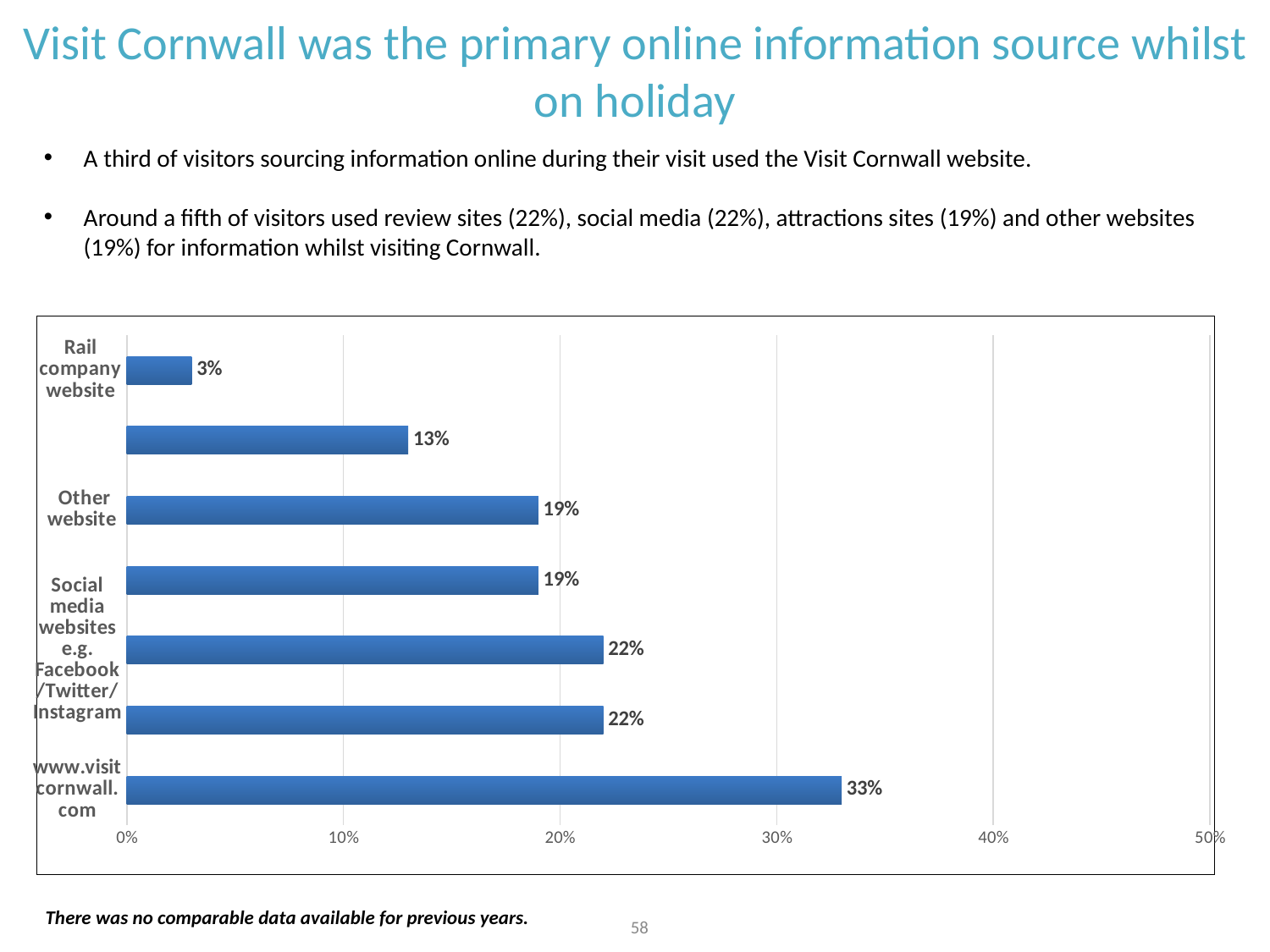
Is the value for Rail company website greater or less than 10%? less Is the value for www.visitcornwall.com greater or less than 30%? greater What is the value for Rail company website? 3% How many bars are plotted in the chart? 7 What is the value for www.visitcornwall.com? 33% What kind of chart is shown on the slide? Bar chart Which category has the highest value? www.visitcornwall.com What is the value for Other website? 19% Which is larger, the value for www.visitcornwall.com or the value for Other website? www.visitcornwall.com What is the difference between the values for www.visitcornwall.com and Rail company website? 30 percentage points What is the highest value shown on the horizontal axis? 50% Which category has the lowest value? Rail company website